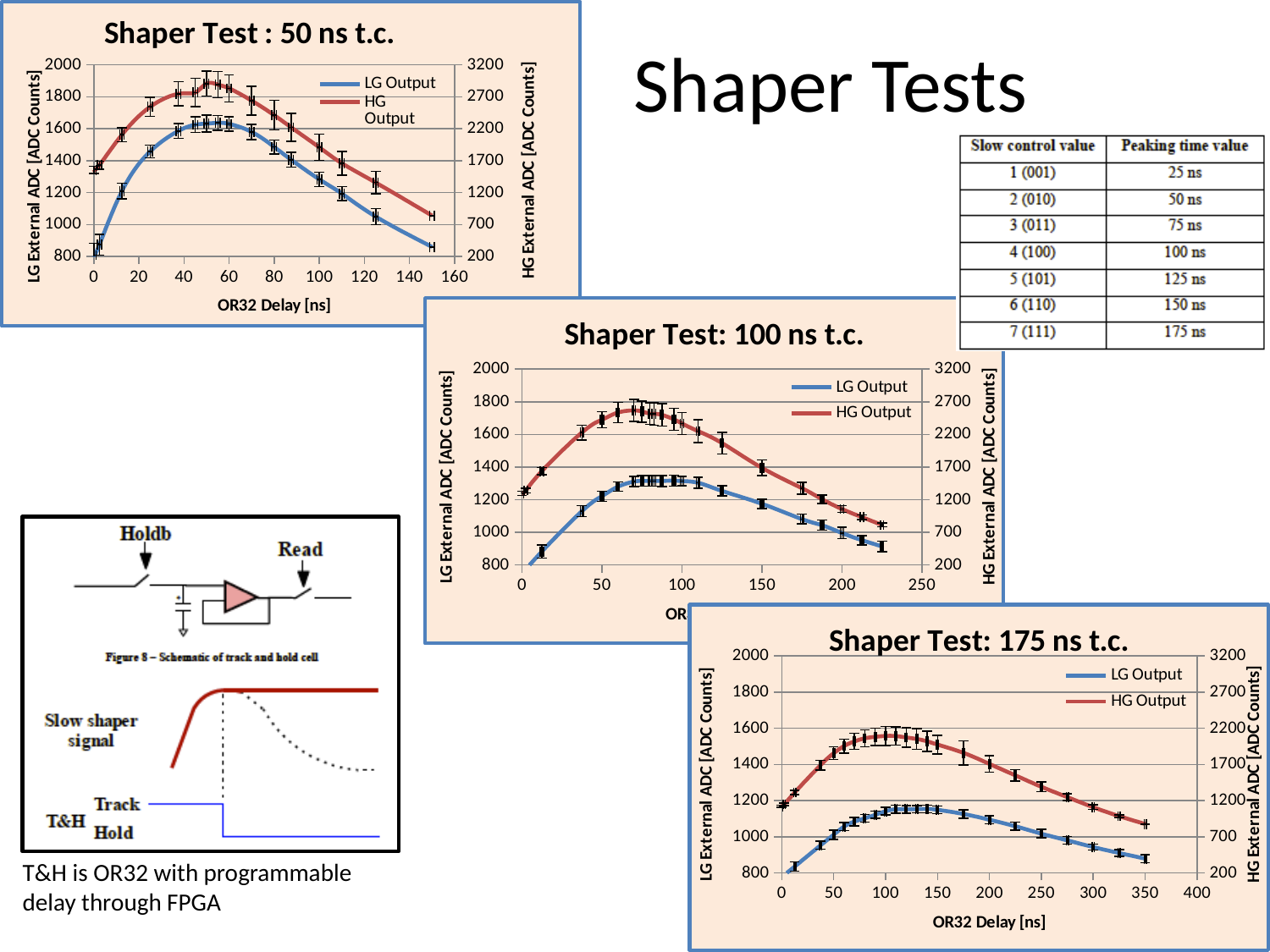
What is the x-axis label of the 'Shaper Test: 175 ns t.c.' chart? OR32 Delay [ns] In the 'Shaper Test: 100 ns t.c.' chart, is the peak LG Output value greater or less than 1400? less What kind of chart is the 'Shaper Test : 50 ns t.c.' chart? line chart In the 'Shaper Test: 175 ns t.c.' chart, does the HG Output rise or fall as the delay increases from 0 ns to 50 ns? rise In the 'Shaper Test : 50 ns t.c.' chart, is the peak LG Output value greater or less than 1400? greater In the 'Shaper Test : 50 ns t.c.' chart, is the LG Output value at 150 ns delay greater or less than 1000? less In the 'Shaper Test: 175 ns t.c.' chart, which series is drawn in red? HG Output In the 'Shaper Test : 50 ns t.c.' chart, does the LG Output rise or fall as the delay increases from 100 ns to 150 ns? fall In the 'Shaper Test: 100 ns t.c.' chart, does the HG Output rise or fall as the delay increases from 150 ns to 225 ns? fall How many series does the legend of the 'Shaper Test: 100 ns t.c.' chart list? 2